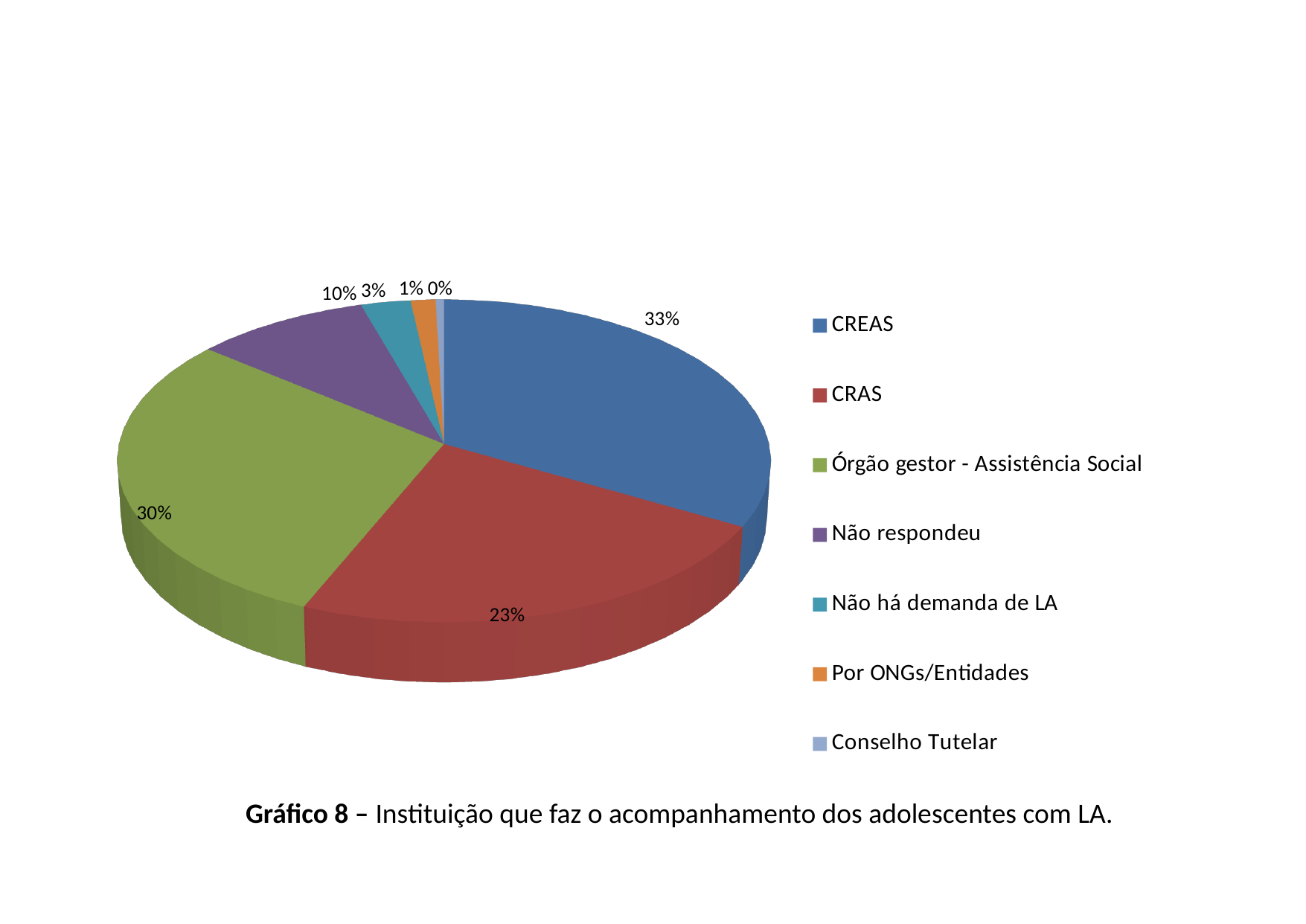
What share of the pie does CREAS have? 33% How many categories does the legend list? 7 Which category has the largest slice of the pie? CREAS What is the difference between the shares of CREAS and CRAS? 10% What kind of chart is shown on the slide? pie chart What share of the pie does CRAS have? 23% What share of the pie does Não respondeu have? 10% Which category has the smallest slice of the pie? Conselho Tutelar What share of the pie does Por ONGs/Entidades have? 1% Which is larger, the share for Órgão gestor - Assistência Social or the share for CRAS? Órgão gestor - Assistência Social What share of the pie does Não há demanda de LA have? 3% What share of the pie does Órgão gestor - Assistência Social have? 30%